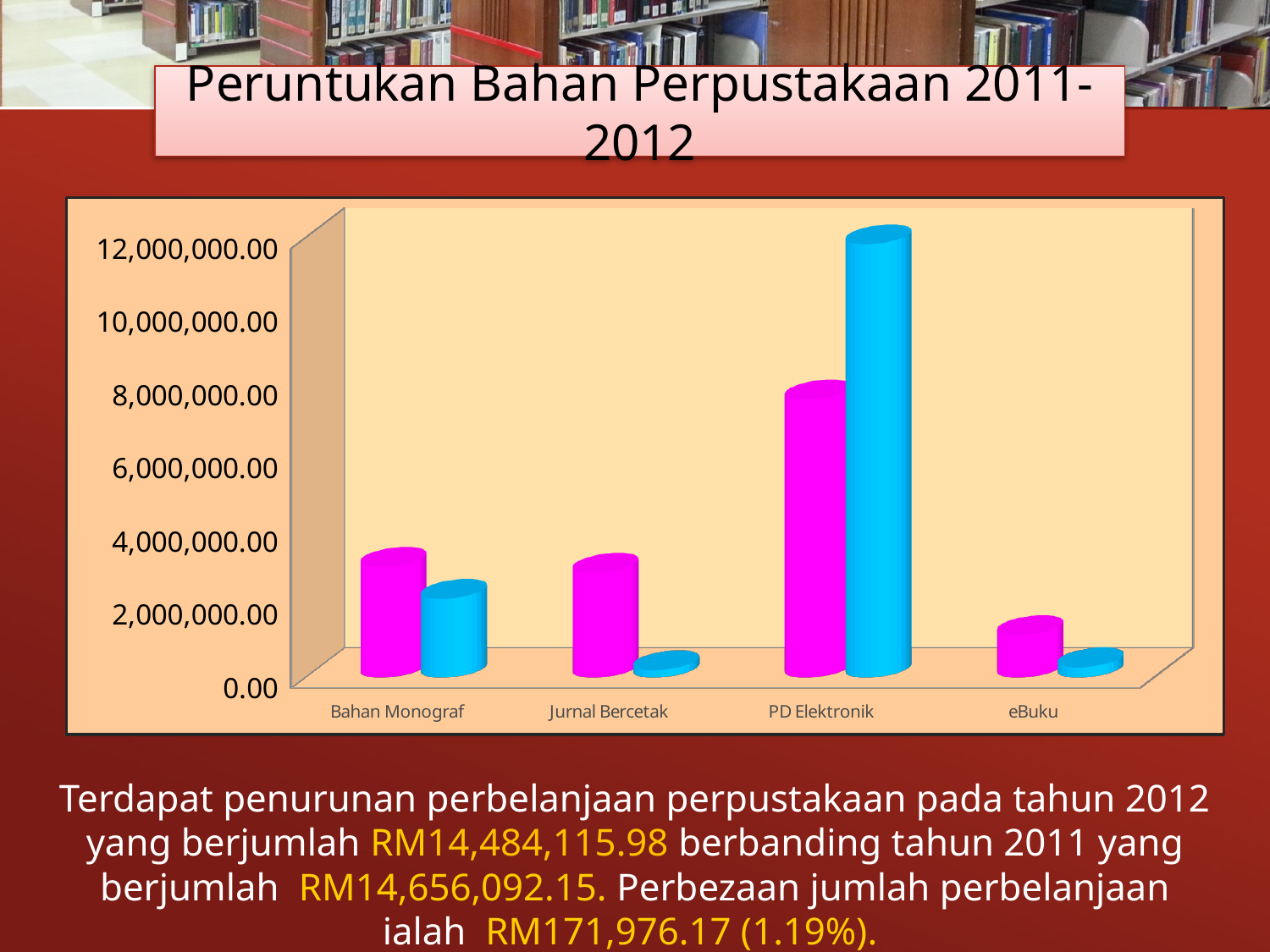
For PD Elektronik, which bar is taller, the magenta (first) bar or the blue (second) bar? the blue (second) bar For Bahan Monograf, which bar is taller, the magenta (first) bar or the blue (second) bar? the magenta (first) bar Is the blue (second) bar for Jurnal Bercetak greater or less than 2,000,000.00? less Which category has the shortest magenta (first) bar? eBuku Which category has the tallest magenta (first) bar? PD Elektronik What is the title of the chart on the slide? Peruntukan Bahan Perpustakaan 2011-2012 How many categories are shown on the x axis of the chart? 4 Which category has the tallest blue (second) bar? PD Elektronik Is the blue (second) bar for PD Elektronik greater or less than 10,000,000.00? greater What kind of chart is shown on the slide? bar chart Is the magenta (first) bar for PD Elektronik greater or less than 6,000,000.00? greater How many bars are plotted for each category in the chart? 2